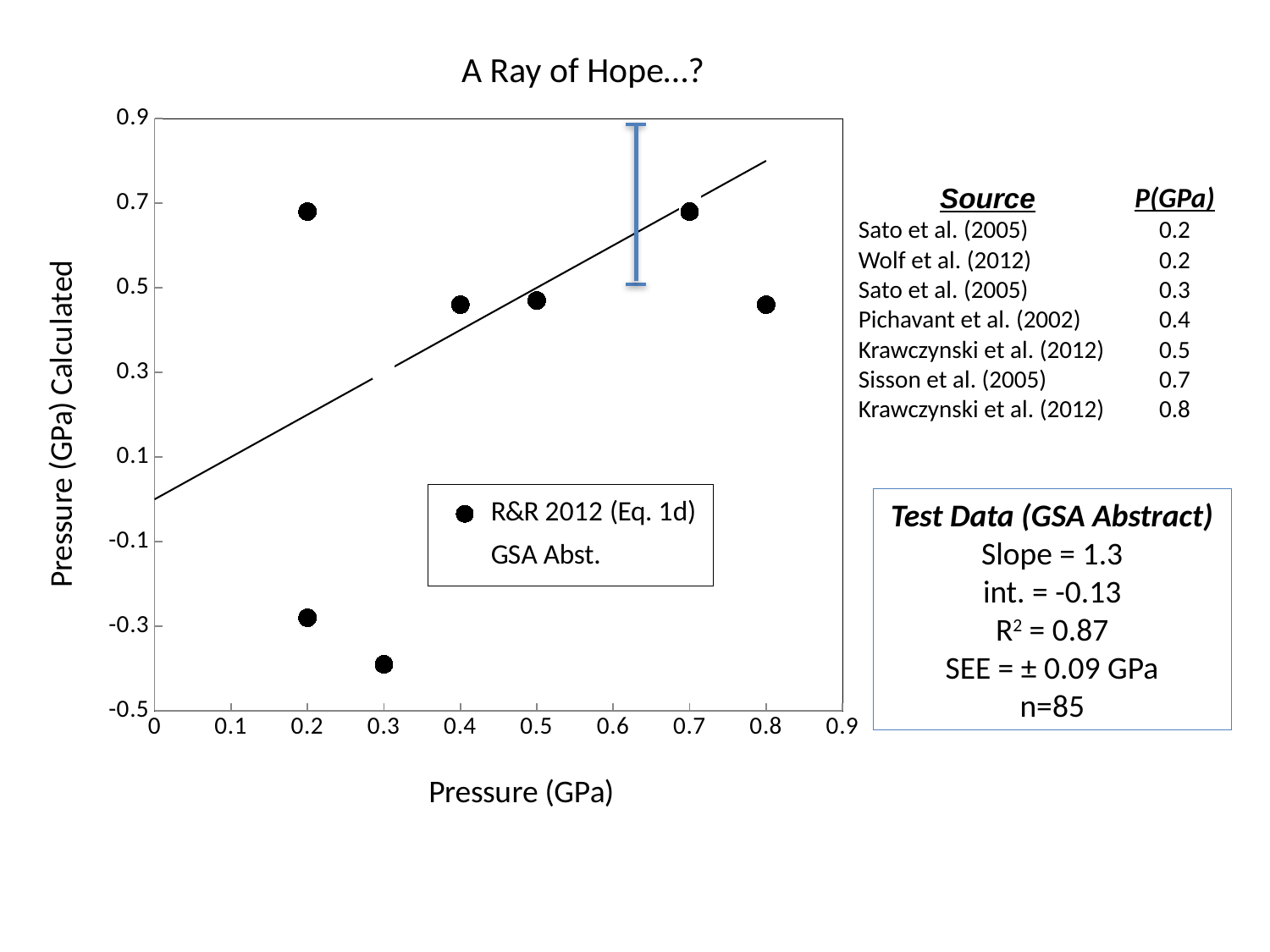
Is the calculated pressure for the point at x = 0.7 GPa greater or less than 0.5? greater Does the GSA Abst. fitted line rise or fall as pressure increases along the x axis? Rises What is the label of the x axis? Pressure (GPa) Is the calculated pressure for the point at x = 0.3 GPa greater or less than -0.3? less Is the calculated pressure for the point at x = 0.4 GPa greater or less than 0.3? greater At which x value does the lowest plotted point occur? 0.3 What is the title of the chart? A Ray of Hope...? How many data points are plotted for the R&R 2012 (Eq. 1d) series? 7 How many plotted points have an x value of 0.2 GPa? 2 What kind of chart is shown on the slide? Scatter chart How many entries does the chart legend list? 2